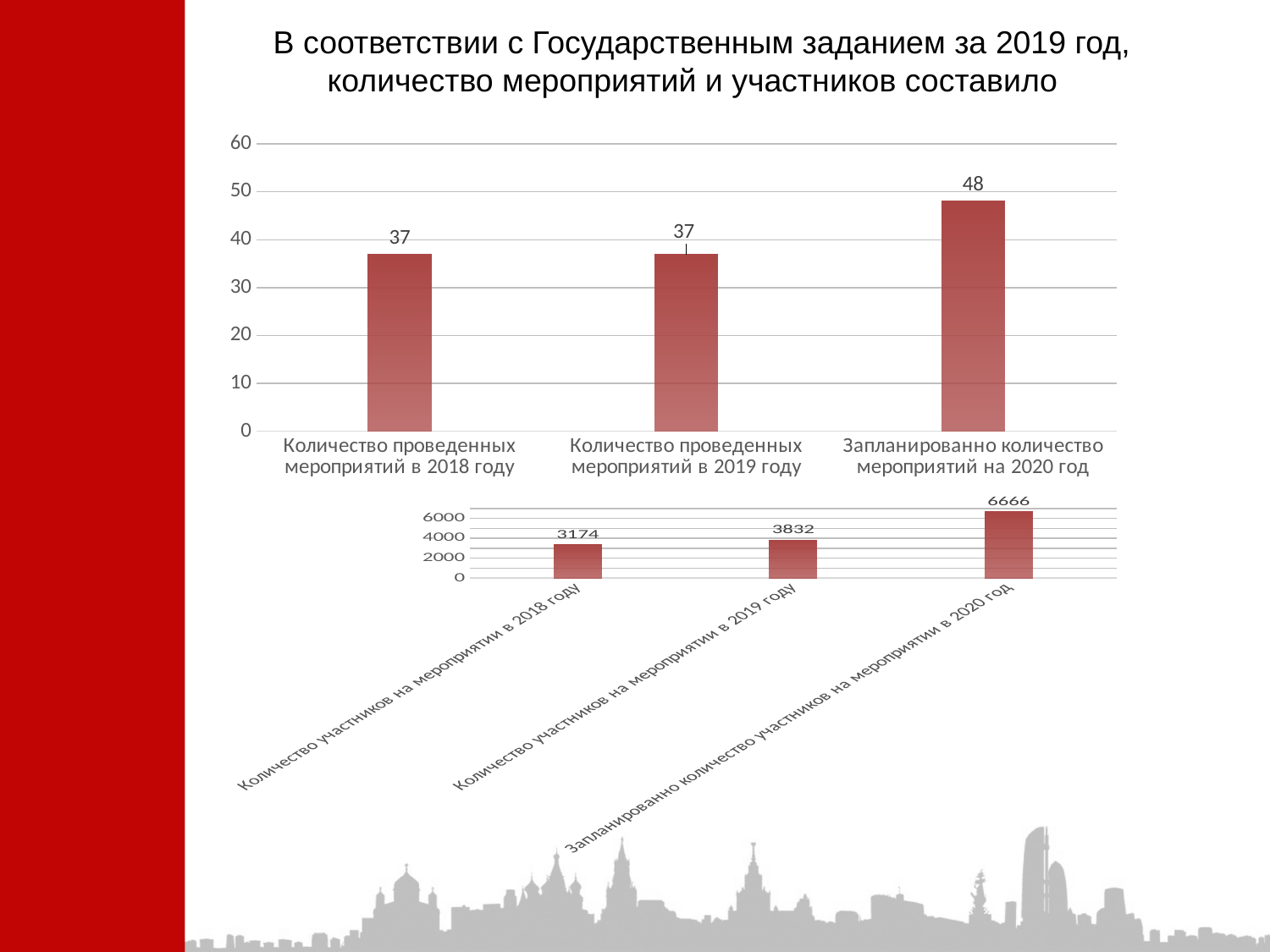
In the bottom chart, what is the value for 'Запланированно количество участников на мероприятии в 2020 год'? 6666 In the top chart, how many bars are plotted? 3 In the bottom chart, do the values rise or fall from left to right? Rise In the top chart, which category has the highest value? Запланированно количество мероприятий на 2020 год In the top chart, what is the value for 'Запланированно количество мероприятий на 2020 год'? 48 In the top chart, what is the difference between the planned number of events for 2020 and the number of events held in 2019? 11 In the bottom chart, which category has the lowest value? Количество участников на мероприятии в 2018 году In the bottom chart, what is the difference between the number of participants in 2019 and in 2018? 658 What type of chart is the top chart? Bar chart In the bottom chart, what is the value for 'Количество участников на мероприятии в 2018 году'? 3174 In the bottom chart, is the value for 'Количество участников на мероприятии в 2019 году' greater or less than 4000? less In the top chart, what is the value for 'Количество проведенных мероприятий в 2019 году'? 37